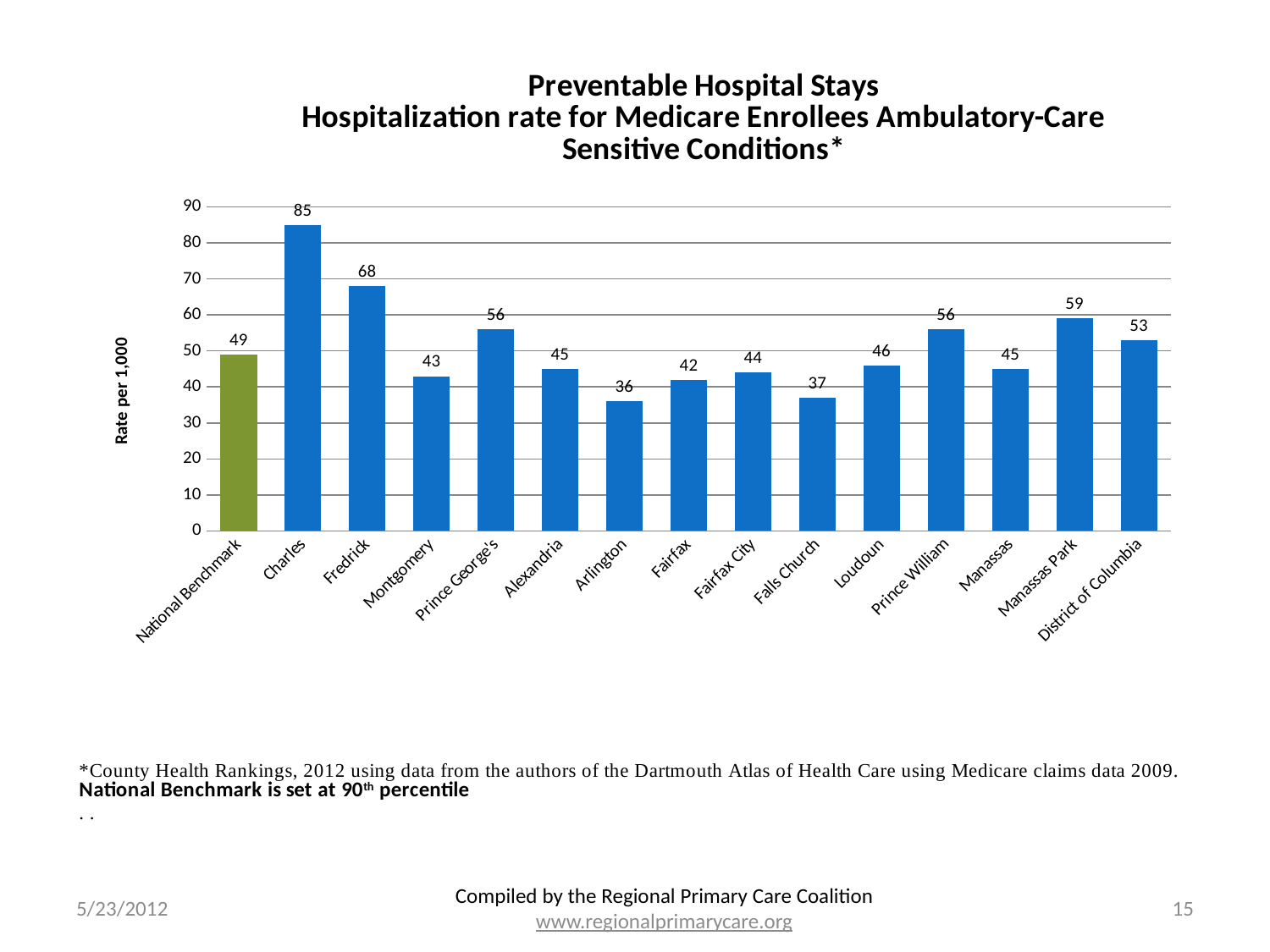
Which category has the highest value? Charles What is the value for the National Benchmark? 49 What is the label of the y axis? Rate per 1,000 Which is larger, the value for Falls Church or the value for Loudoun? Loudoun What is the value for Charles? 85 What is the value for Arlington? 36 What is the difference between the values for Manassas Park and the National Benchmark? 10 Which is larger, the value for Montgomery or the value for Prince George's? Prince George's Which category has the lowest value? Arlington How many categories are shown on the x axis? 15 What is the difference between the values for Charles and Fredrick? 17 What kind of chart is shown on the slide? Bar chart